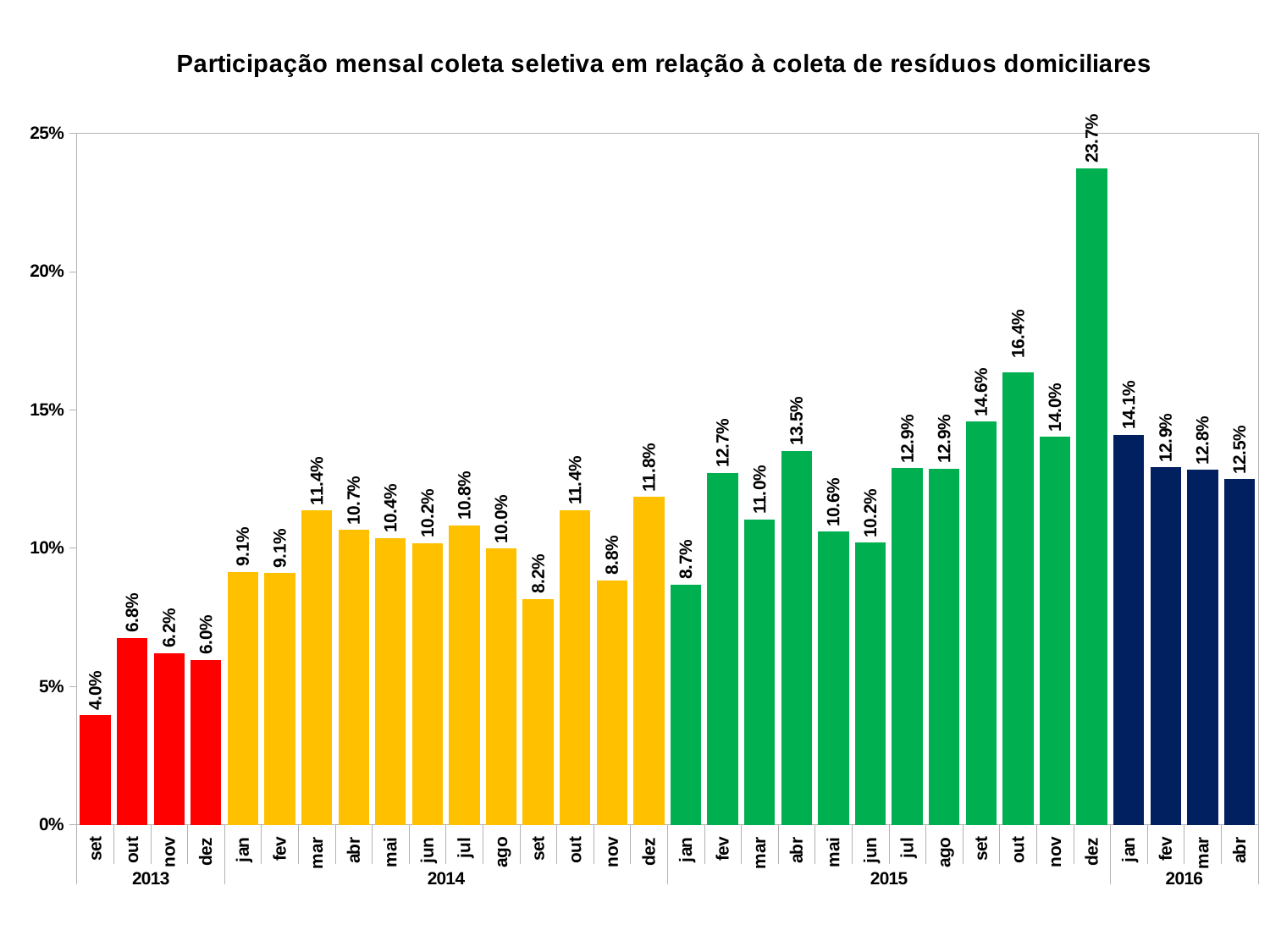
What is the value for dez 2015? 23.7% How many bars are plotted in the chart? 32 What is the difference between the values for dez 2015 and out 2015? 7.3% Which month has the highest value? dez 2015 Which is larger, the value for mar 2014 or the value for mar 2015? mar 2014 What is the value for set 2013? 4.0% Do the values rise or fall from jan 2016 to abr 2016? fall Which month has the lowest value? set 2013 What colour are the bars for 2015? green What is the value for abr 2016? 12.5% What kind of chart is shown on the slide? bar chart Is the value for jan 2016 greater or less than 15%? less